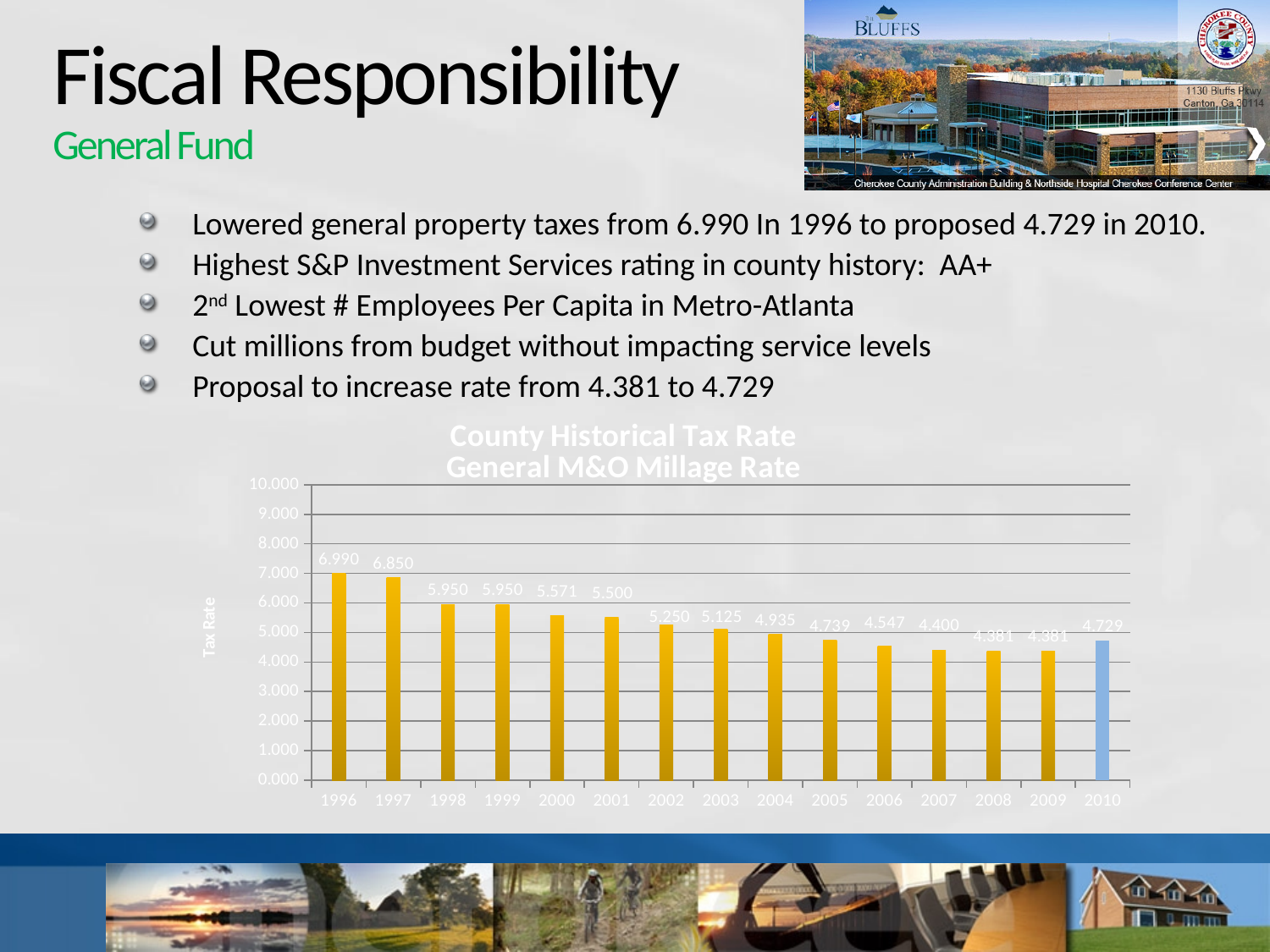
Is the value for 2001 greater or less than 5.000? greater Which is larger, the tax rate for 2005 or the tax rate for 2010? 2005 What is the lowest tax rate value shown in the chart? 4.381 What is the difference between the tax rate in 1996 and the tax rate in 2009? 2.609 What is the tax rate shown for 2004? 4.935 How many years are shown on the x axis of the chart? 15 What is the label on the vertical axis of the chart? Tax Rate What kind of chart is shown on the slide? Bar chart What is the tax rate shown for 2010? 4.729 Which year has the highest tax rate in the chart? 1996 What is the tax rate shown for 1996? 6.990 Do the tax rate values generally rise or fall from 1996 to 2009? Fall